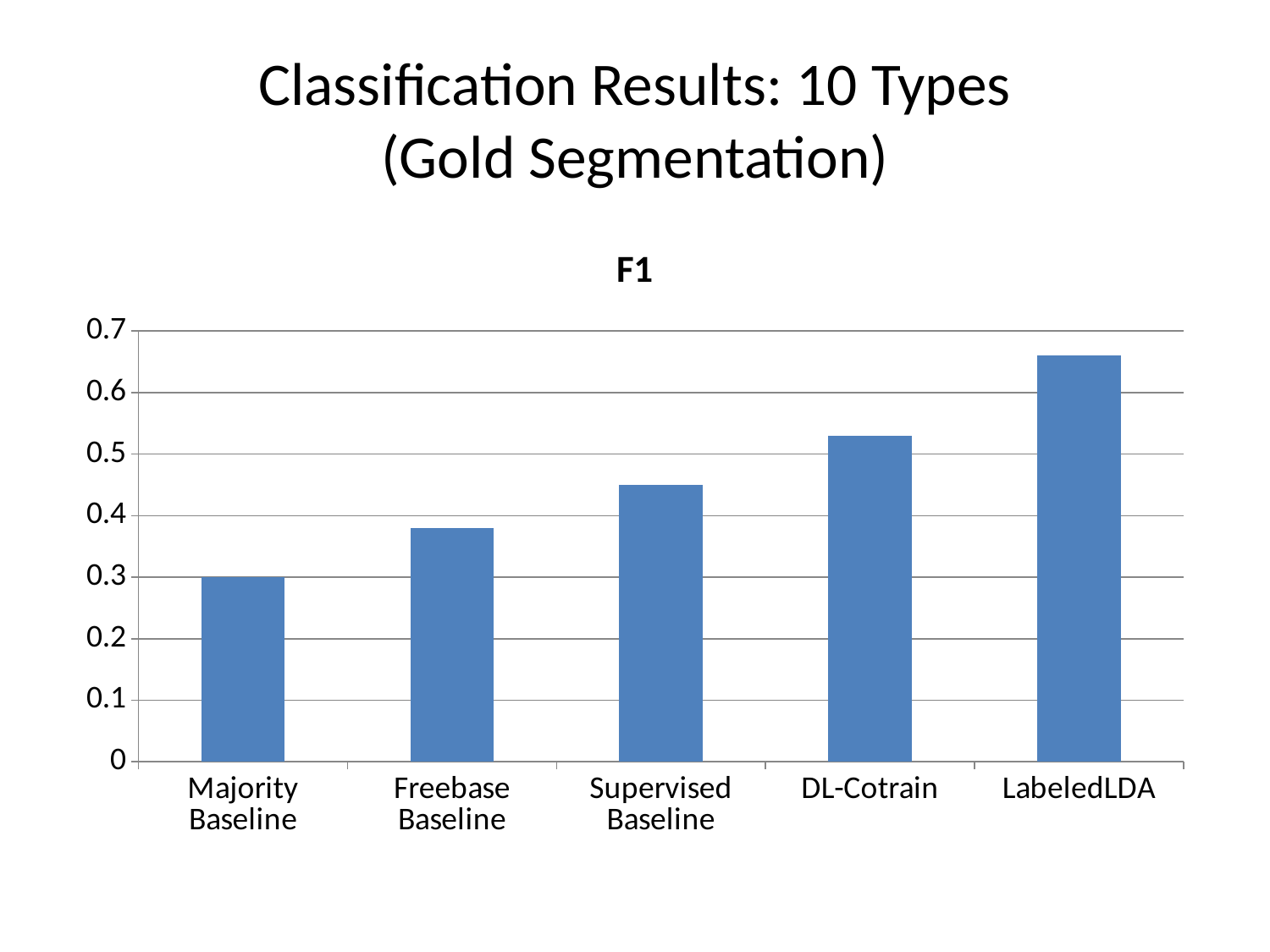
What is the F1 value for Majority Baseline? 0.3 Which method has the highest F1? LabeledLDA Which has a higher F1, DL-Cotrain or Supervised Baseline? DL-Cotrain How many methods are compared in the chart? 5 Is the F1 value for Supervised Baseline greater or less than 0.5? less Is the F1 value for DL-Cotrain greater or less than 0.5? greater Is the F1 value for LabeledLDA greater or less than 0.6? greater Do the F1 values rise or fall from left to right across the methods? Rise What kind of chart is shown on the slide? Bar chart What is the title of the chart? F1 Which method has the lowest F1? Majority Baseline